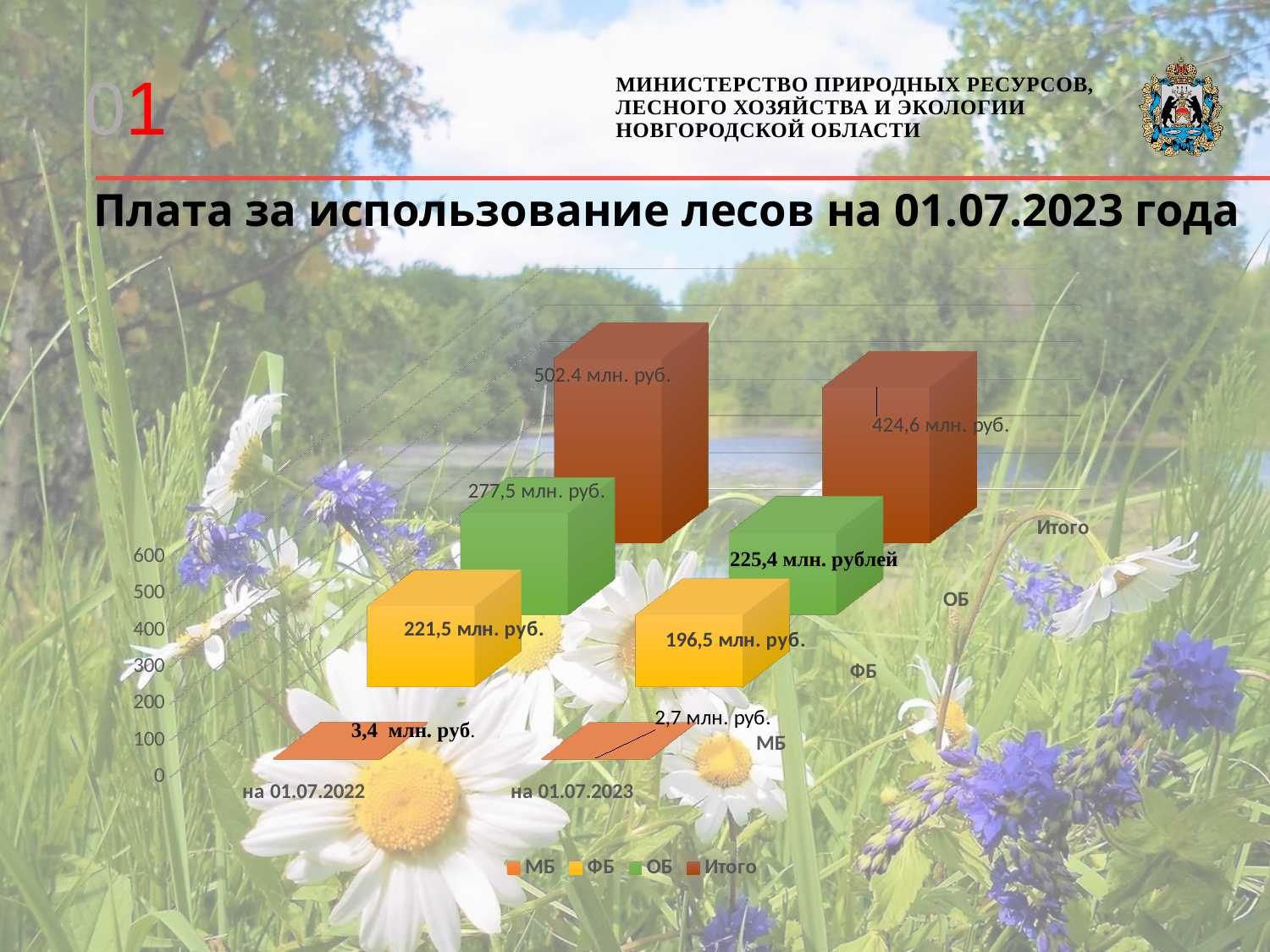
What is the value of ОБ for на 01.07.2022? 277,5 млн. руб. How many categories are shown on the x axis? 2 What is the value of МБ for на 01.07.2023? 2,7 млн. руб. What is the value of Итого for на 01.07.2023? 424,6 млн. руб. What is the value of ФБ for на 01.07.2023? 196,5 млн. руб. Which series has the lowest value for на 01.07.2022? МБ Which is larger, ФБ for на 01.07.2022 or ФБ for на 01.07.2023? ФБ for на 01.07.2022 What type of chart is shown on the slide? bar chart How many series does the legend list? 4 What is the difference between ФБ for на 01.07.2022 and ФБ for на 01.07.2023? 25 млн. руб. What is the value of Итого for на 01.07.2022? 502.4 млн. руб. Does the Итого value fall or rise from на 01.07.2022 to на 01.07.2023? fall